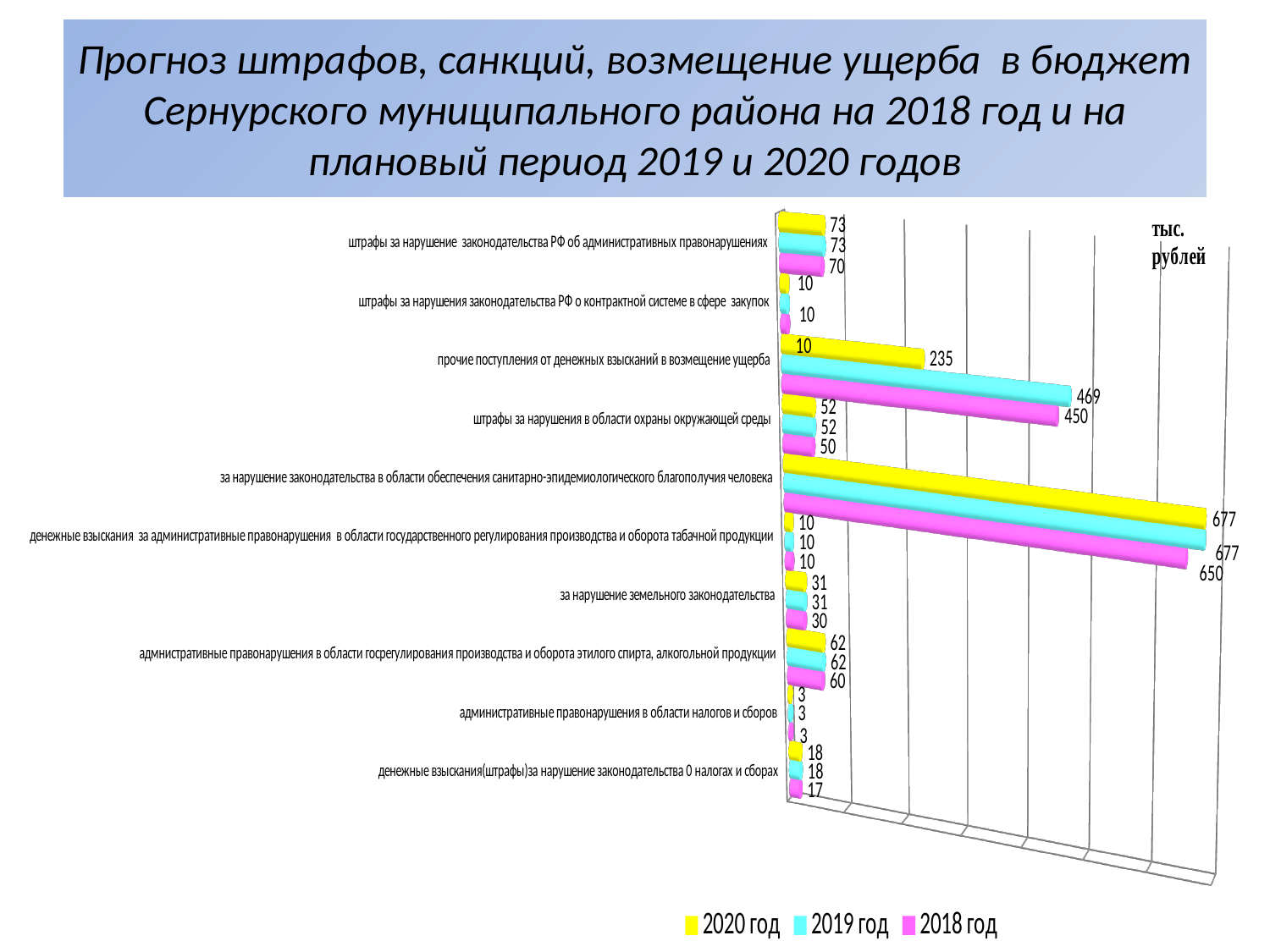
How many categories are shown on the chart? 10 Which category has the highest 2020 год value? за нарушение законодательства в области обеспечения санитарно-эпидемиологического благополучия человека What type of chart is shown on the slide? Bar chart What unit is indicated in the top-right corner of the chart? тыс. рублей What is the 2019 год value for 'за нарушение законодательства в области обеспечения санитарно-эпидемиологического благополучия человека'? 677 What is the 2018 год value for 'за нарушение земельного законодательства'? 30 What is the difference between the 2019 год and 2020 год values for 'прочие поступления от денежных взысканий в возмещение ущерба'? 234 What is the 2018 год value for 'прочие поступления от денежных взысканий в возмещение ущерба'? 450 Which category has the lowest 2019 год value? административные правонарушения в области налогов и сборов Which is larger for 'штрафы за нарушение законодательства РФ об административных правонарушениях': the 2020 год value or the 2018 год value? 2020 год How many series does the legend list? 3 What is the 2020 год value for 'прочие поступления от денежных взысканий в возмещение ущерба'? 235